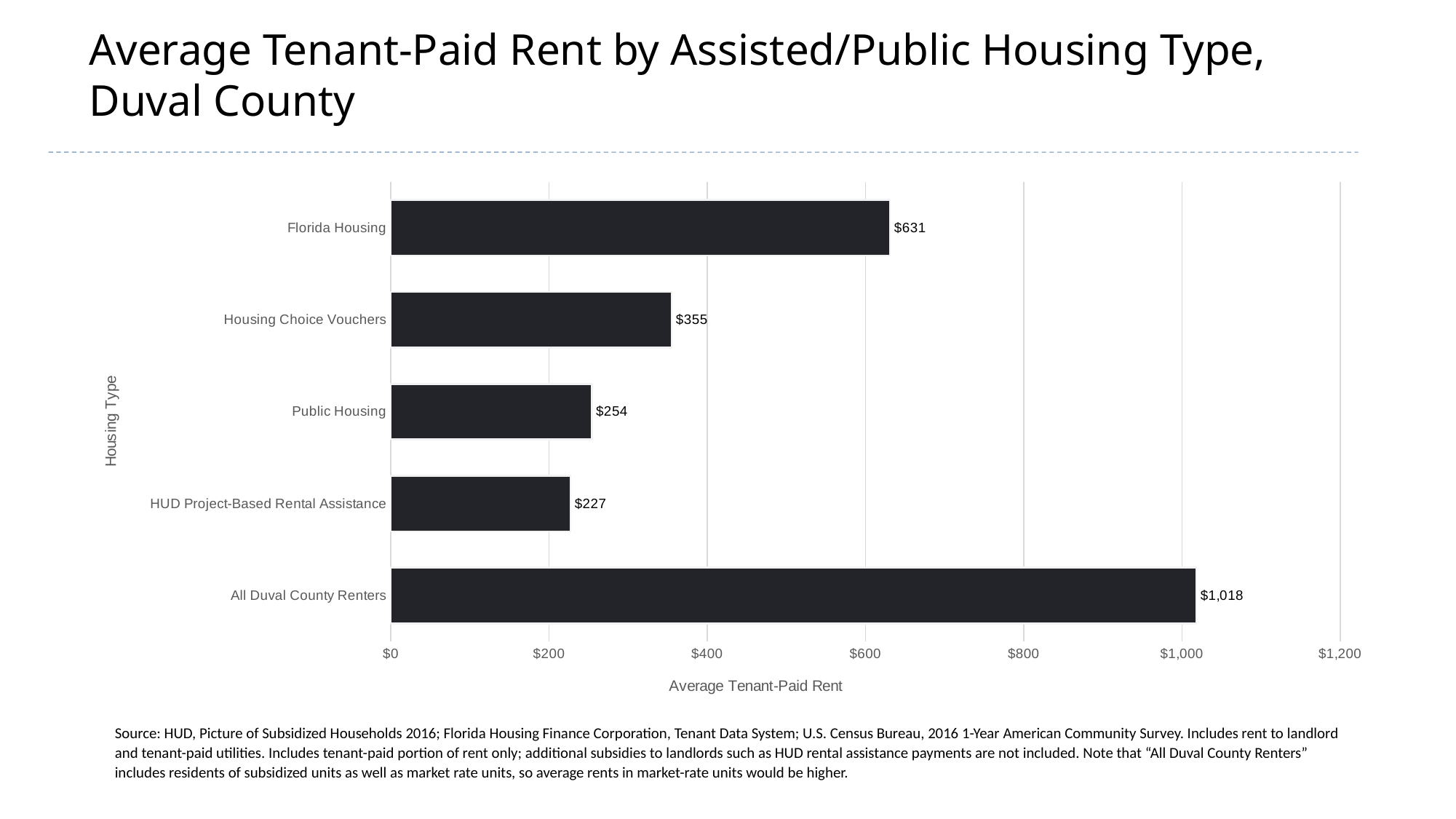
What is the average tenant-paid rent for All Duval County Renters? $1,018 What is the average tenant-paid rent for Housing Choice Vouchers? $355 What is the average tenant-paid rent for HUD Project-Based Rental Assistance? $227 Which has a higher average tenant-paid rent, Housing Choice Vouchers or Public Housing? Housing Choice Vouchers What is the difference in average tenant-paid rent between All Duval County Renters and Florida Housing? $387 What is the average tenant-paid rent for Public Housing? $254 What is the label of the horizontal axis? Average Tenant-Paid Rent Which housing type has the lowest average tenant-paid rent? HUD Project-Based Rental Assistance What type of chart is shown on the slide? Bar chart Which housing type has the highest average tenant-paid rent? All Duval County Renters What is the average tenant-paid rent for Florida Housing? $631 How many housing types are shown in the chart? 5